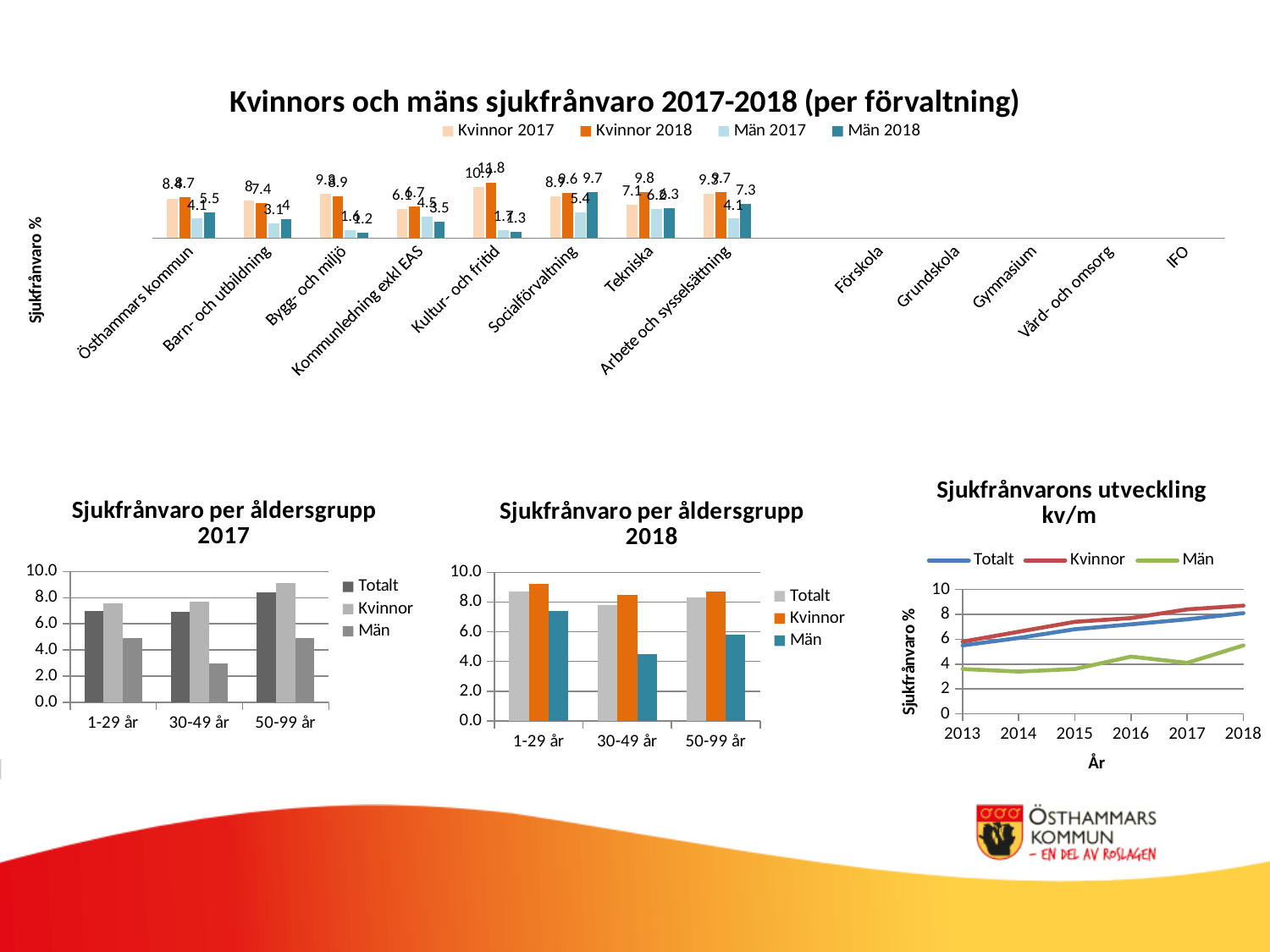
In the chart 'Kvinnors och mäns sjukfrånvaro 2017-2018 (per förvaltning)', what is the value for Män 2018 in Östhammars kommun? 5.5 What kind of chart is 'Sjukfrånvarons utveckling kv/m'? Line chart In the chart 'Sjukfrånvaro per åldersgrupp 2017', is the value for Män in 30-49 år greater or less than 4.0? less In the chart 'Sjukfrånvaro per åldersgrupp 2017', which age group has the highest Kvinnor value? 50-99 år In the chart 'Kvinnors och mäns sjukfrånvaro 2017-2018 (per förvaltning)', what is the value for Män 2018 in Arbete och sysselsättning? 7.3 In the chart 'Sjukfrånvarons utveckling kv/m', does the Kvinnor line rise or fall from 2013 to 2018? Rise In the chart 'Kvinnors och mäns sjukfrånvaro 2017-2018 (per förvaltning)', how many series does the legend list? 4 In the chart 'Kvinnors och mäns sjukfrånvaro 2017-2018 (per förvaltning)', what is the value for Kvinnor 2018 in Tekniska? 9.8 In the chart 'Sjukfrånvaro per åldersgrupp 2018', which age group has the lowest Män value? 30-49 år In the chart 'Kvinnors och mäns sjukfrånvaro 2017-2018 (per förvaltning)', what is the difference between Män 2018 and Män 2017 in Socialförvaltning? 4.3 In the chart 'Sjukfrånvarons utveckling kv/m', how many years are shown on the x axis? 6 In the chart 'Sjukfrånvaro per åldersgrupp 2018', which is larger for 1-29 år: Kvinnor or Män? Kvinnor